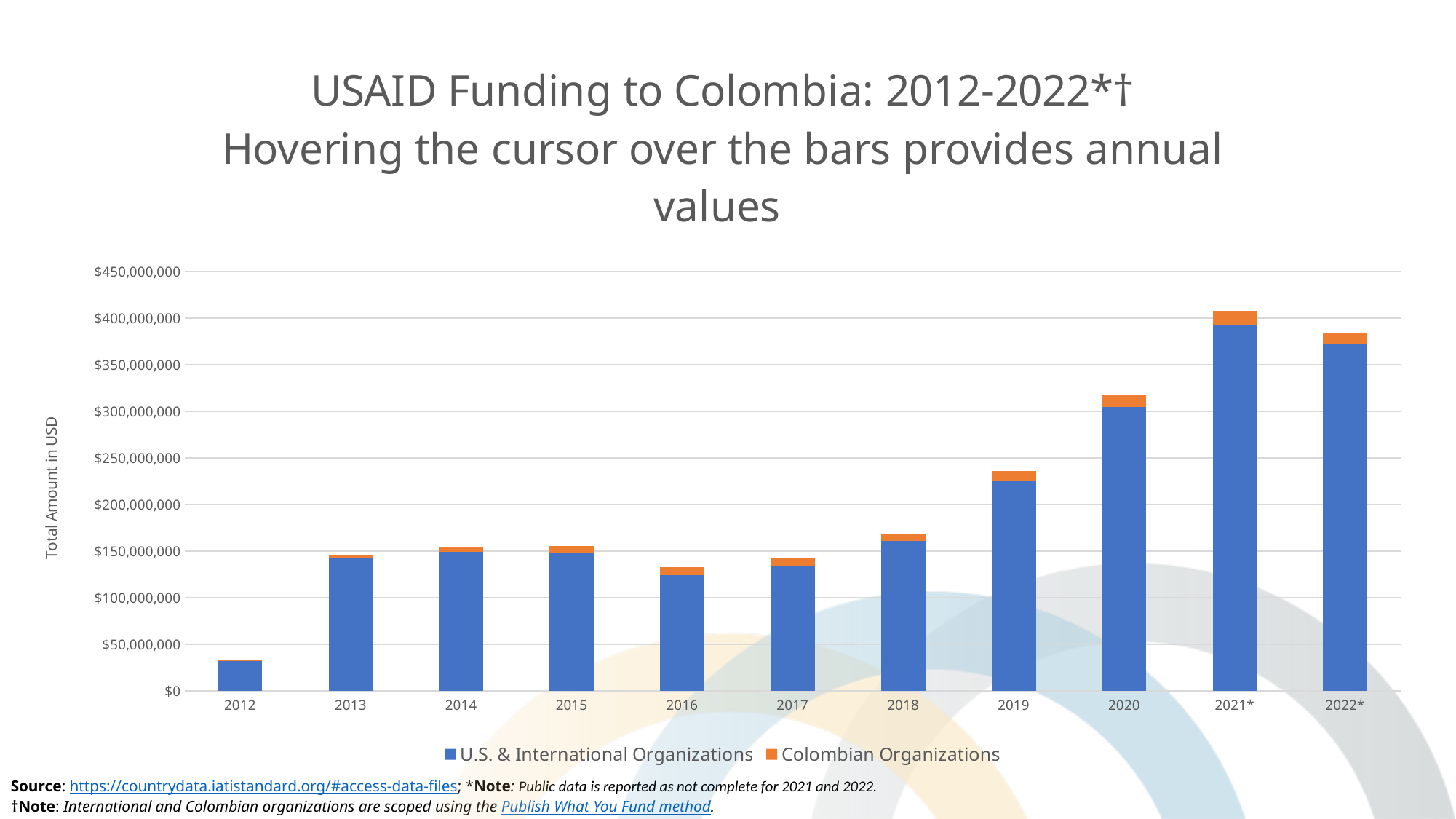
How many series does the chart's legend list? 2 Do the total funding bars rise or fall from 2018 to 2021*? Rise What kind of chart is shown on the slide? Stacked bar chart Which year has the lowest total funding bar? 2012 Is the total funding for 2022* greater or less than $400,000,000? less What is the label on the chart's y axis? Total Amount in USD Is the total funding for 2020 greater or less than $300,000,000? greater Which year has the larger total funding bar, 2015 or 2016? 2015 How many years are shown on the x axis of the chart? 11 Which year has the highest total funding bar? 2021* Is the total funding for 2016 greater or less than $150,000,000? less